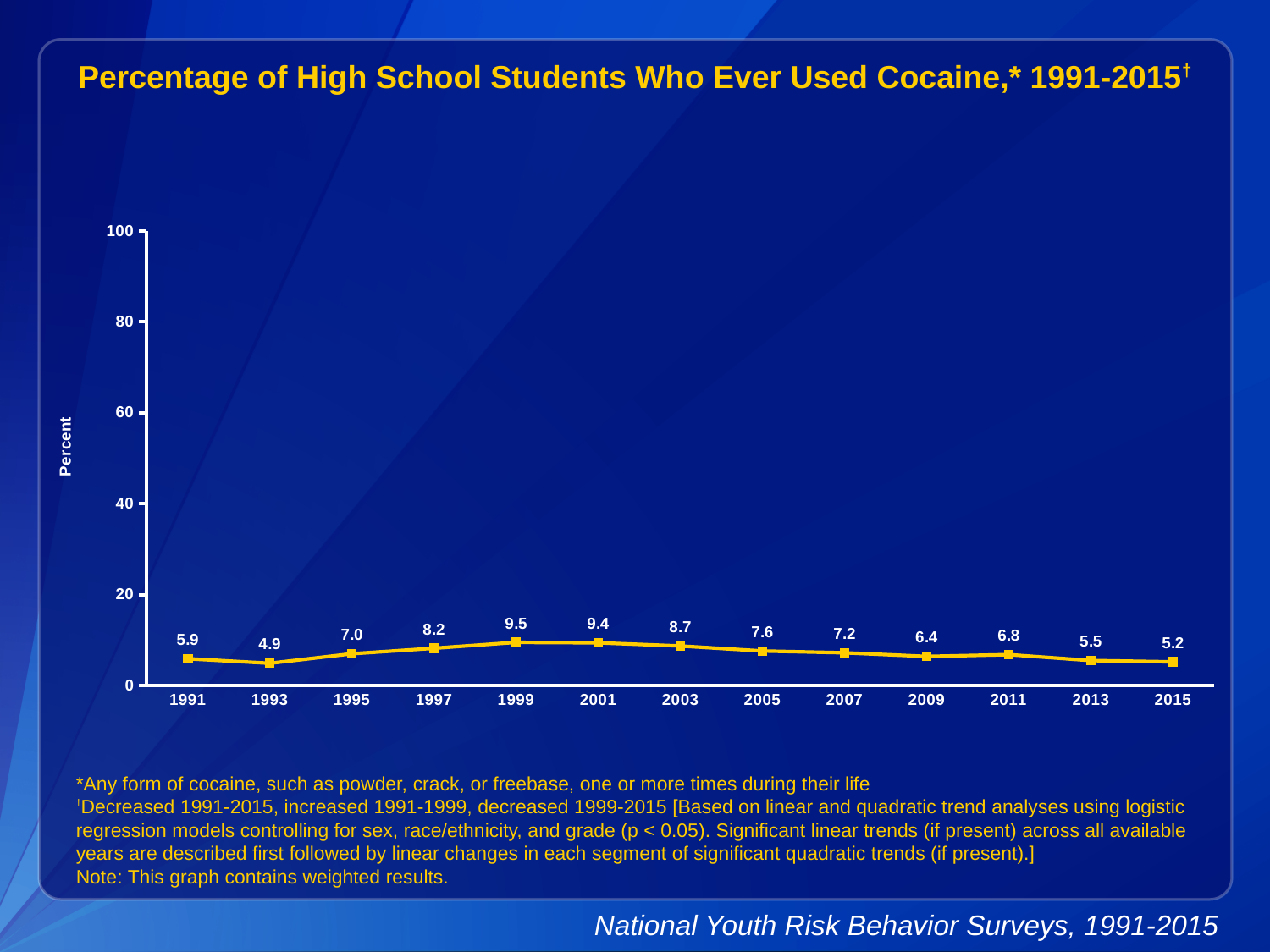
Which year has the highest percentage of students who ever used cocaine? 1999 What is the difference between the 1999 value and the 2015 value? 4.3 Which year has the lowest percentage of students who ever used cocaine? 1993 What percentage of high school students had ever used cocaine in 1999? 9.5 Which year has a larger value, 2003 or 2009? 2003 What is the label on the y axis? Percent What is the value plotted for 2015? 5.2 How many years are plotted on the x axis? 13 Do the values rise or fall from 1999 to 2015? fall What kind of chart is shown on the slide? line chart Is the value for 2001 greater or less than 20? less What is the value plotted for 1991? 5.9